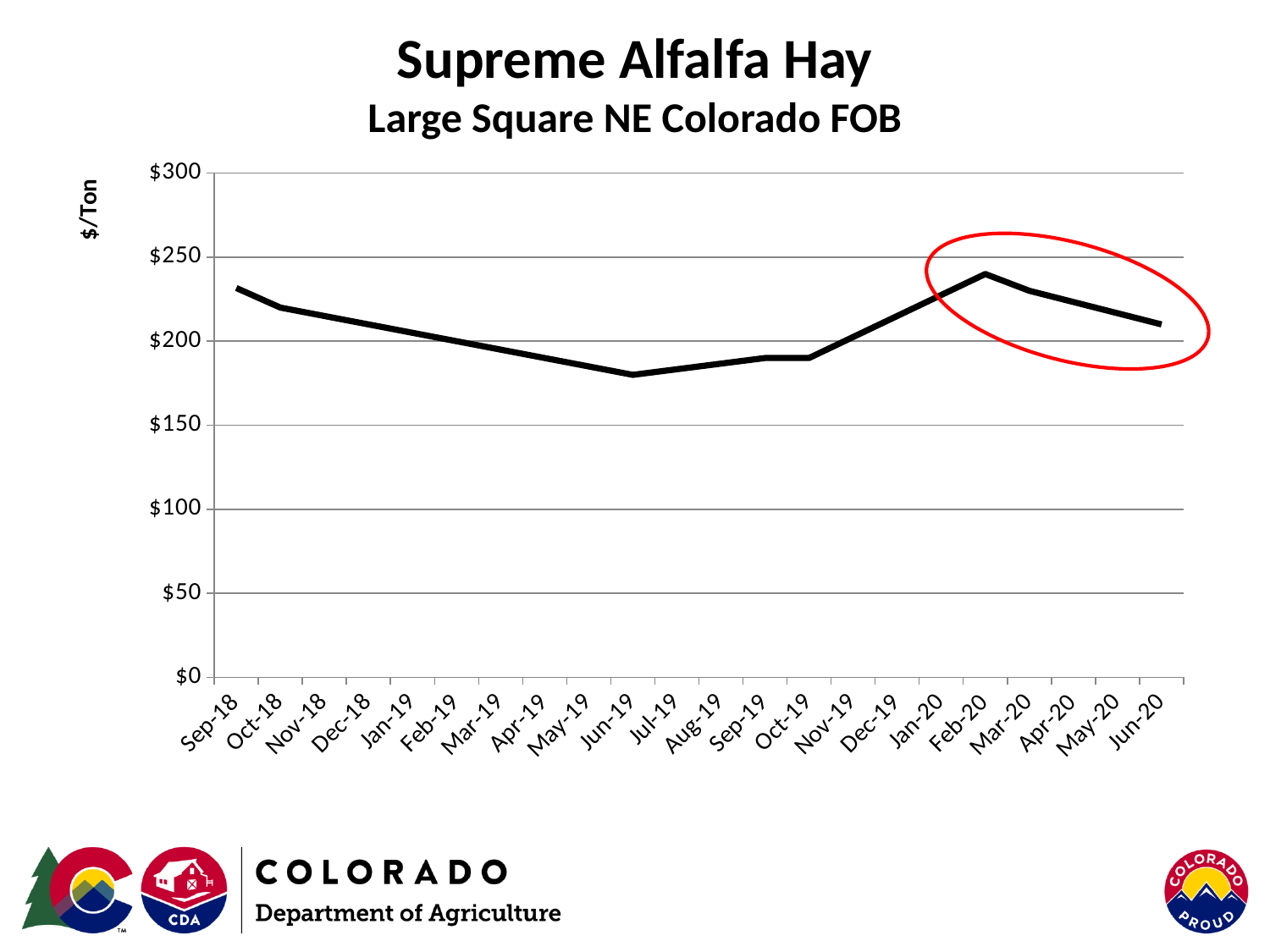
Do prices rise or fall from Sep-18 to Jun-19? fall What kind of chart is shown on the slide? line chart Is the value for Sep-18 greater or less than $200? greater Is the value for Feb-20 greater or less than $200? greater What is the title of the chart? Supreme Alfalfa Hay, Large Square NE Colorado FOB Which is larger, the value for Sep-18 or the value for Jun-19? Sep-18 How many months are labelled along the x axis? 22 Is the value for Jun-19 greater or less than $200? less What is the label on the vertical axis? $/Ton Do prices rise or fall from Jun-19 to Feb-20? rise Which month has the lowest price on the chart? Jun-19